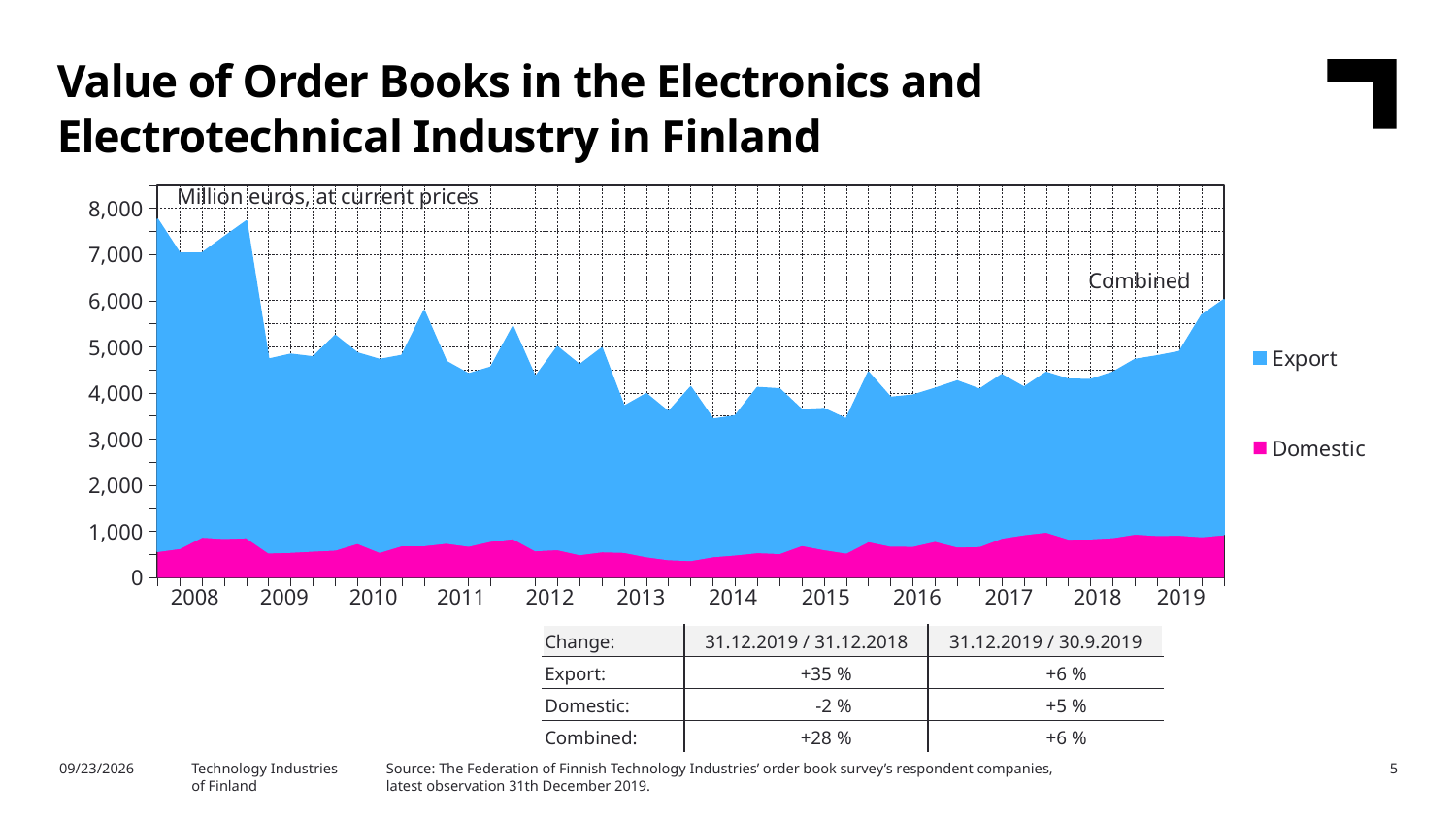
Did the combined value of order books rise or fall over the course of 2019? rise What are the two series named in the chart's legend? Export and Domestic Is the combined value of order books in 2015 greater or less than 5,000? less What unit is stated at the top of the chart's plot area? Million euros, at current prices What kind of chart is shown on the slide? Stacked area chart Which series is larger throughout the chart, Export or Domestic? Export Is the Domestic value of order books in 2013 greater or less than 1,000? less Did the combined value of order books rise or fall between 2008 and 2009? fall How many series does the chart's legend list? 2 How many years are labelled along the x axis of the chart? 12 Is the combined value of order books at the start of 2008 greater or less than 7,000? greater